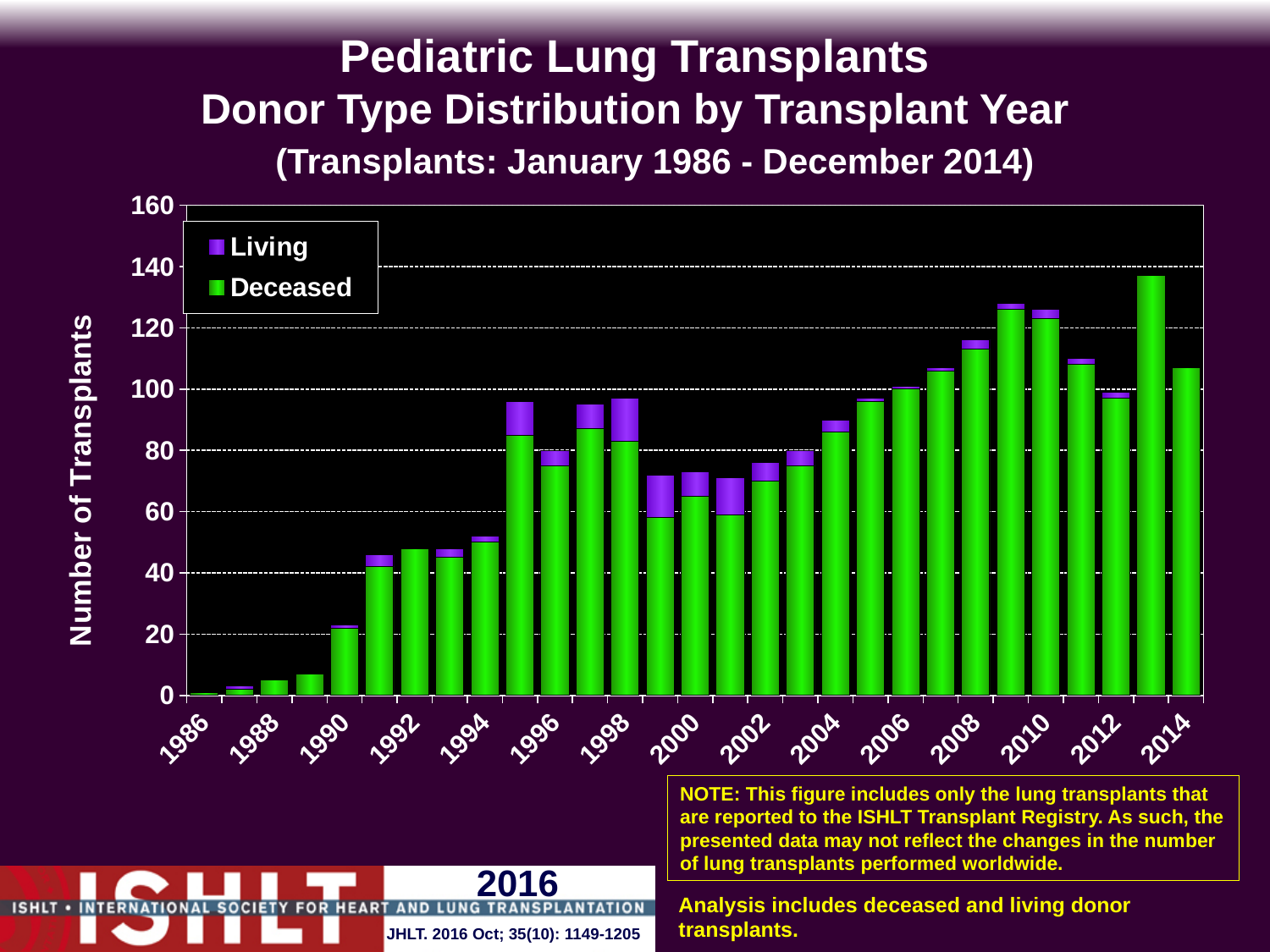
Which year has the highest total number of transplants? 2013 Is the total number of transplants in 2013 greater or less than 120? greater Is the total number of transplants in 2014 greater or less than 100? greater What are the two series named in the legend? Living and Deceased How many transplant years (bars) are plotted on the x axis? 29 Is the total number of transplants in 1999 greater or less than 80? less How many series does the legend list? 2 Do total transplants generally rise or fall from 2003 to 2009? rise Which year has the lowest total number of transplants? 1986 What kind of chart is shown on the slide? Stacked bar chart Which year has more total transplants, 2013 or 2014? 2013